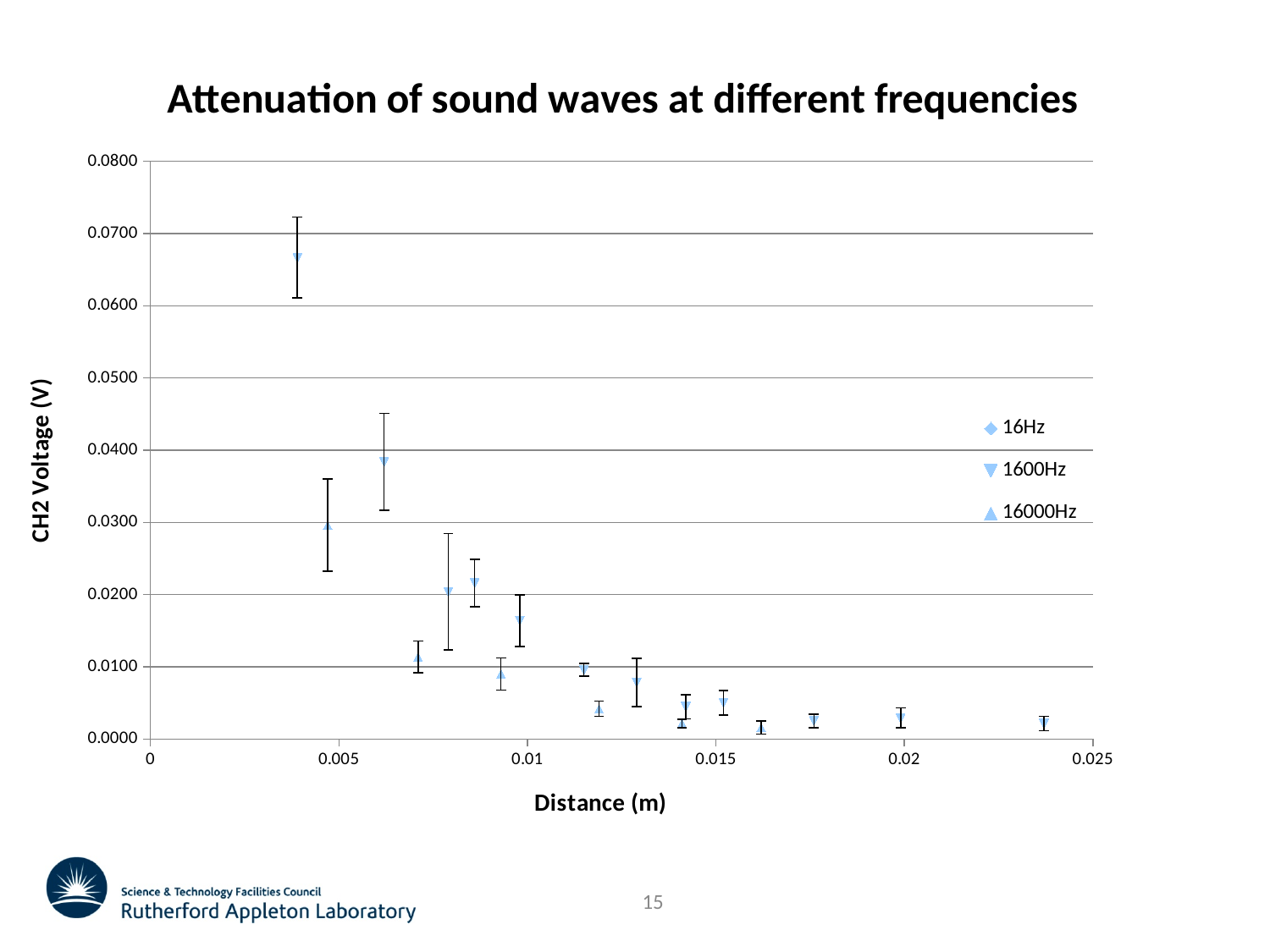
How many series does the legend list? 3 Is the value of the 16000Hz point near 0.005 m greater or less than 0.0400? less What is the label of the vertical axis? CH2 Voltage (V) Do the plotted voltage values rise or fall as distance increases along the x axis? Fall What kind of chart is shown on the slide? Scatter chart Is the value of the rightmost plotted point (near 0.024 m) greater or less than 0.0100? less Is the value of the 1600Hz point near 0.006 m greater or less than 0.0300? greater What is the title of the chart? Attenuation of sound waves at different frequencies Which series contains the highest plotted voltage value? 1600Hz Which series is listed first in the legend? 16Hz Which is larger: the value of the leftmost point near 0.004 m or the value of the point near 0.006 m? The point near 0.004 m